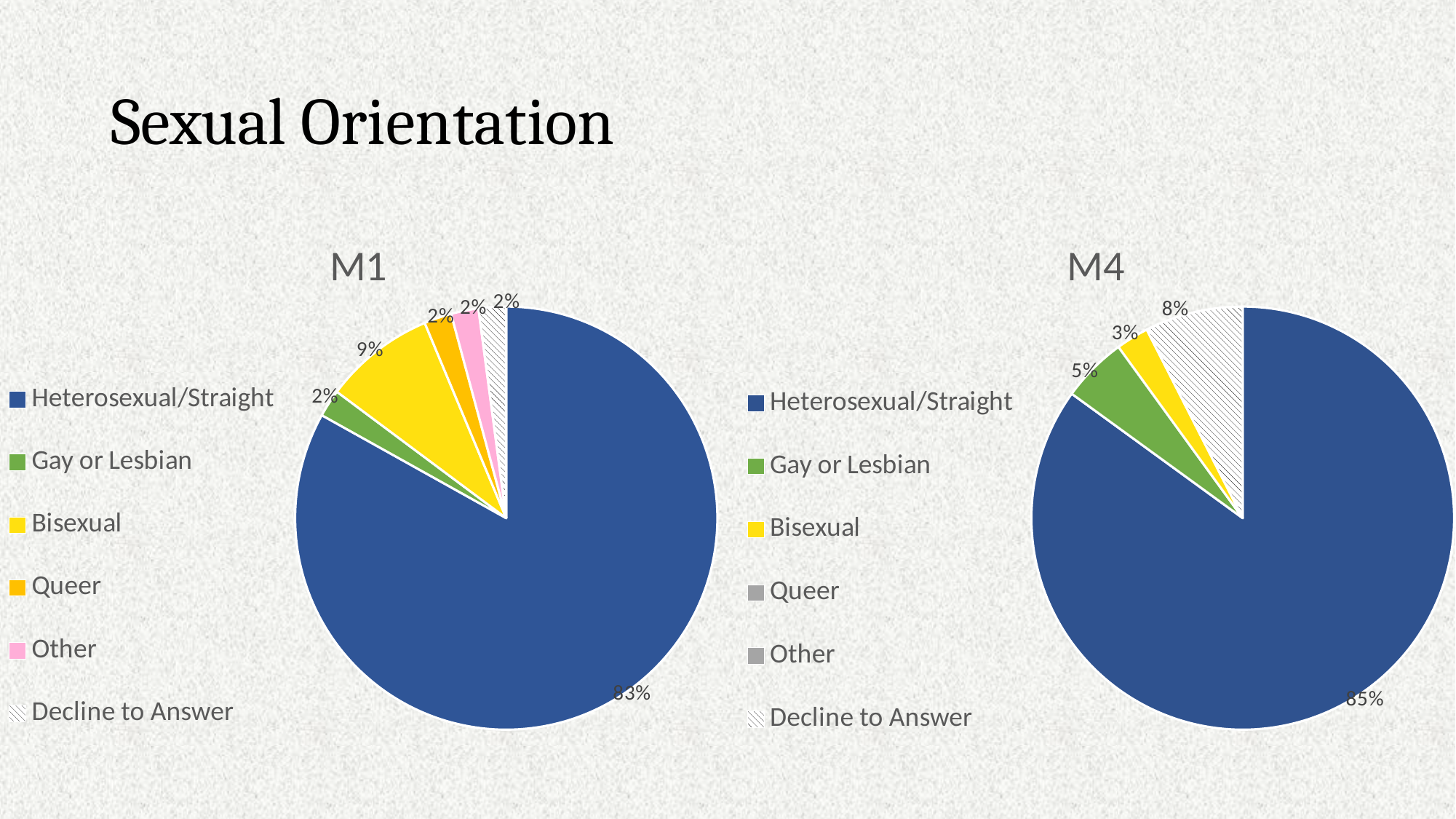
In the M1 pie chart, what percentage is Heterosexual/Straight? 83% What is the difference between the Heterosexual/Straight share in the M4 chart and in the M1 chart? 2% How many categories does the legend of the M1 chart list? 6 In the M1 pie chart, what percentage is Bisexual? 9% In the M1 pie chart, which category has the largest share? Heterosexual/Straight In the M4 pie chart, what percentage is Bisexual? 3% In the M4 pie chart, which is larger, Gay or Lesbian or Bisexual? Gay or Lesbian In the M4 pie chart, what percentage is Decline to Answer? 8% What type of chart is used for M1 and M4? Pie chart In the M4 pie chart, what percentage is Heterosexual/Straight? 85% In the M4 pie chart, which category has the largest share? Heterosexual/Straight In the M4 pie chart, what percentage is Gay or Lesbian? 5%